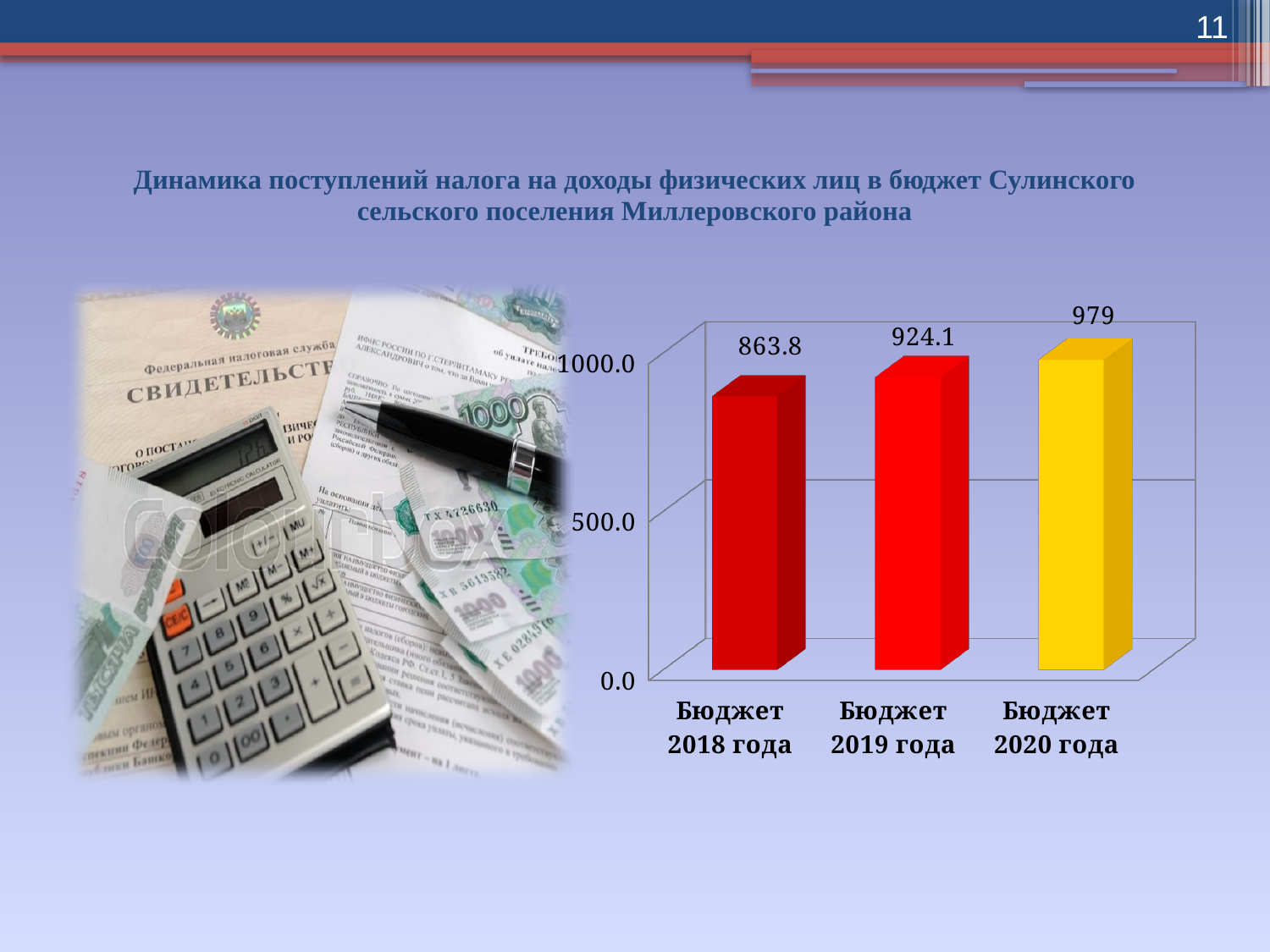
What is the difference between the values for Бюджет 2020 года and Бюджет 2018 года? 115.2 Which category has the lowest value? Бюджет 2018 года Do the values rise or fall from Бюджет 2018 года to Бюджет 2020 года? rise What is the value for Бюджет 2020 года? 979 Which category has the highest value? Бюджет 2020 года Which is larger, the value for Бюджет 2019 года or Бюджет 2020 года? Бюджет 2020 года What kind of chart is shown on the slide? bar chart How many categories are shown on the chart? 3 What is the difference between the values for Бюджет 2019 года and Бюджет 2018 года? 60.3 What is the value for Бюджет 2018 года? 863.8 What is the value for Бюджет 2019 года? 924.1 Is the value for Бюджет 2018 года greater or less than 500.0? greater